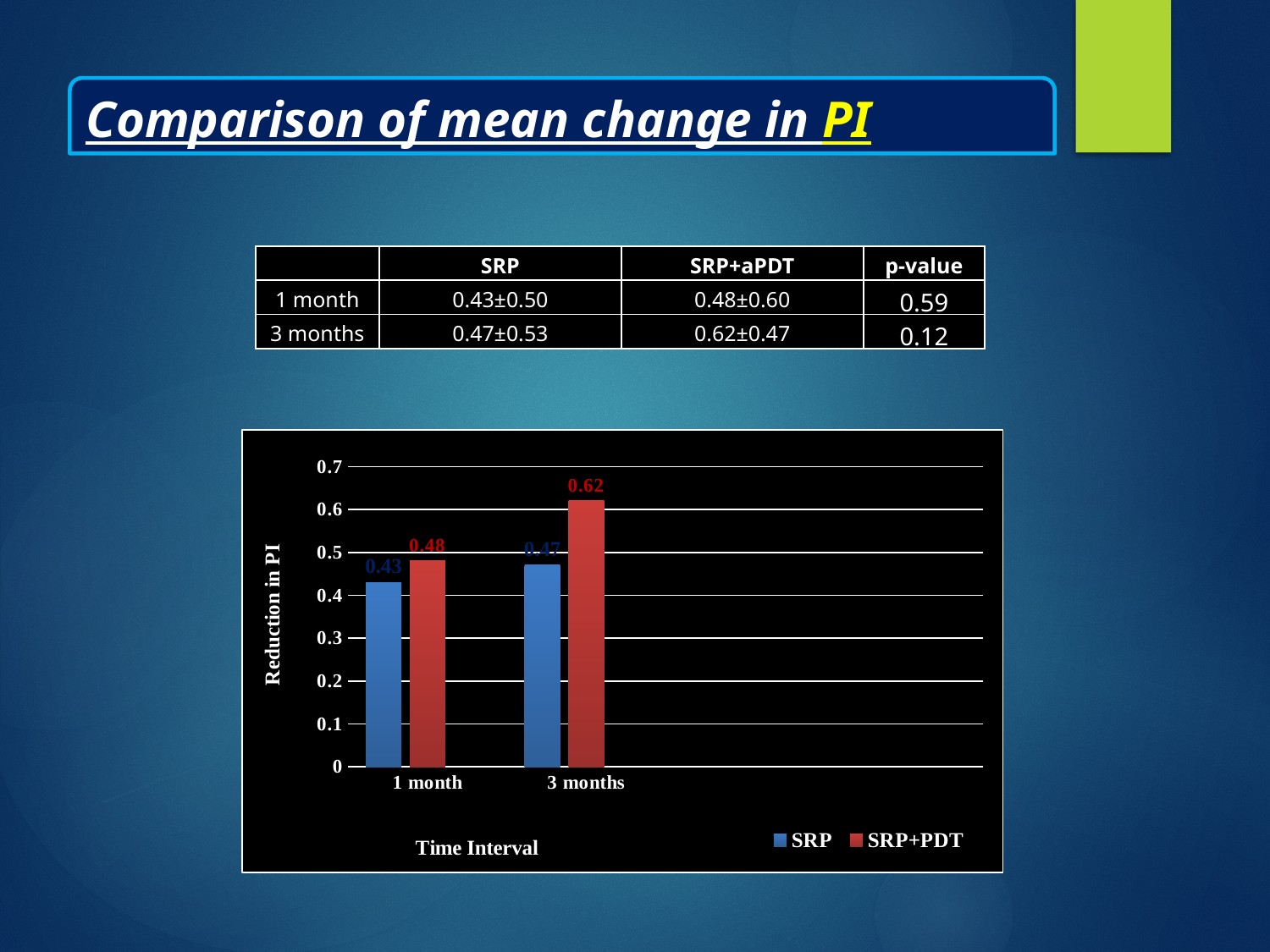
What is the value for SRP at 1 month? 0.43 Is the value for SRP+PDT at 3 months greater or less than 0.5? greater How many series does the legend list? 2 What is the value for SRP+PDT at 1 month? 0.48 Which bar has the lowest value in the chart? SRP at 1 month What is the difference between SRP+PDT and SRP at 3 months? 0.15 What is the value for SRP+PDT at 3 months? 0.62 Which series has the highest value at 3 months? SRP+PDT How many time intervals are shown on the x axis? 2 What kind of chart is shown? bar chart Which is larger at 1 month, SRP or SRP+PDT? SRP+PDT What is the label of the y axis? Reduction in PI